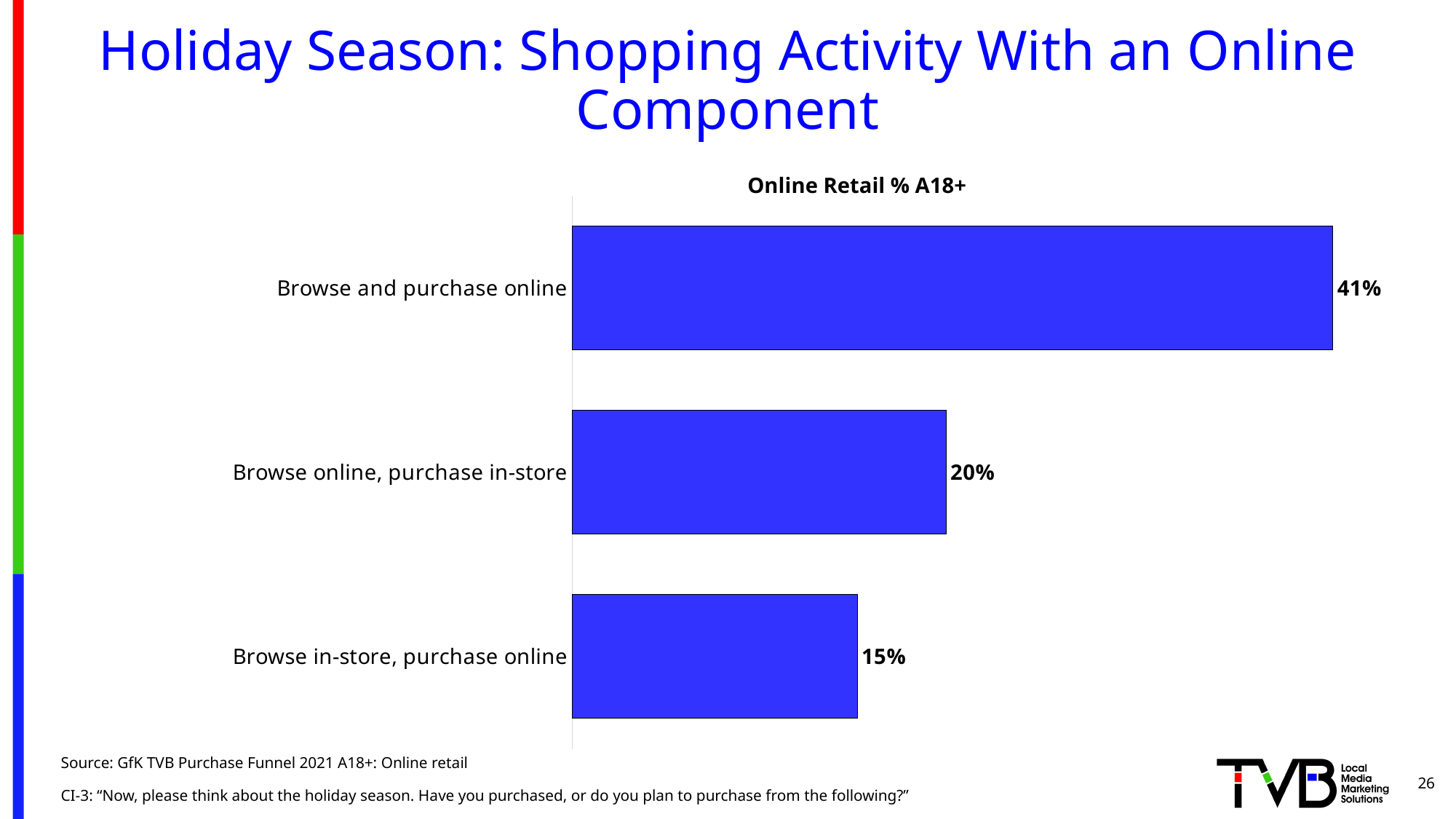
Which category has the highest value? Browse and purchase online What colour are the bars in the chart? Blue What kind of chart is shown on the slide? Bar chart What is the title of the chart? Online Retail % A18+ How many categories are shown in the chart? 3 What is the difference between "Browse online, purchase in-store" and "Browse in-store, purchase online"? 5% What is the value for "Browse and purchase online"? 41% Which category has the lowest value? Browse in-store, purchase online What is the value for "Browse in-store, purchase online"? 15% Which is larger: "Browse online, purchase in-store" or "Browse in-store, purchase online"? Browse online, purchase in-store What is the difference between "Browse and purchase online" and "Browse online, purchase in-store"? 21% What is the value for "Browse online, purchase in-store"? 20%